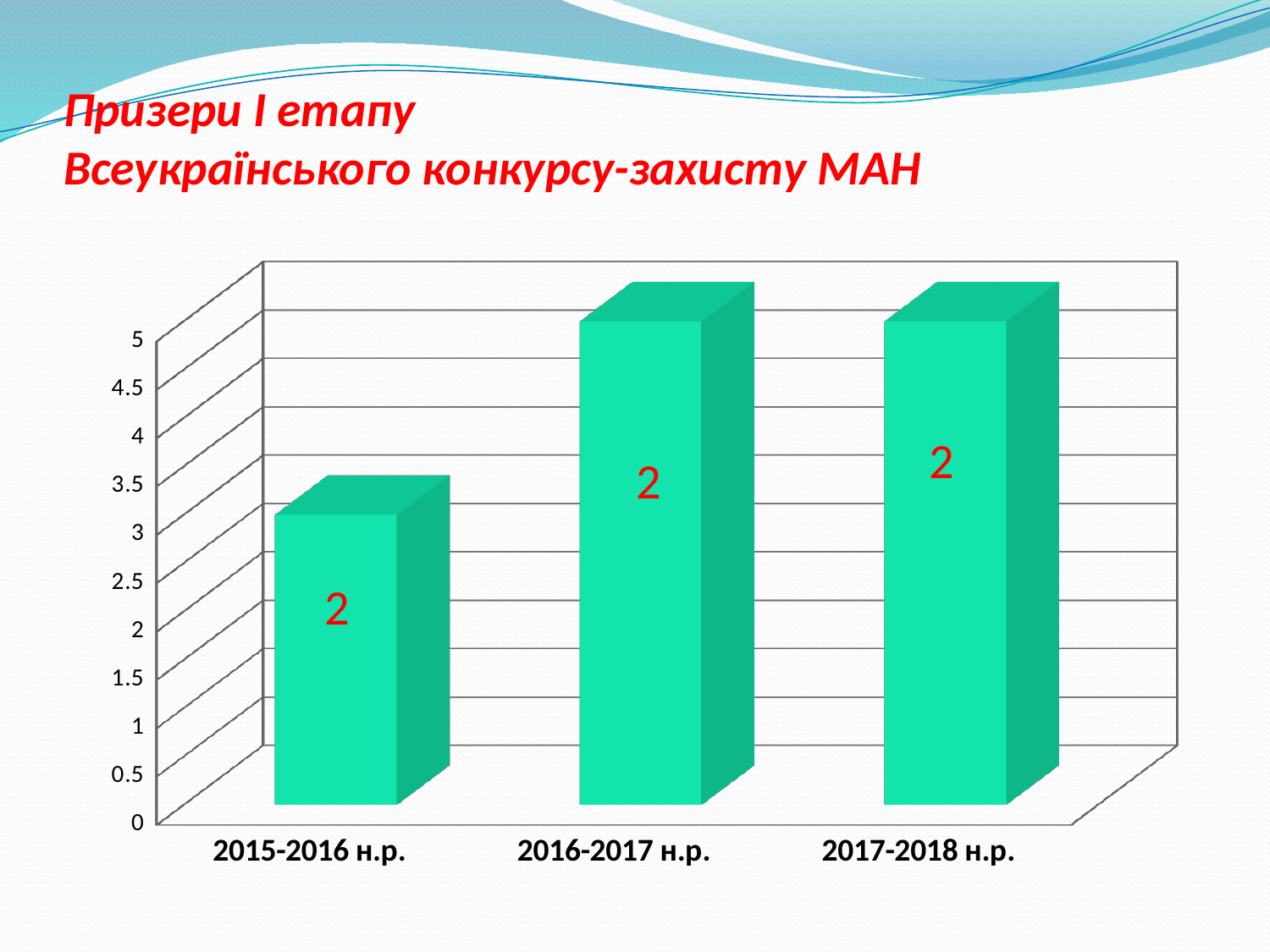
Which category is listed first on the x axis? 2015-2016 н.р. What kind of chart is shown on the slide? bar chart How many categories (academic years) are shown on the x axis? 3 What is the data label shown on the bar for 2017-2018 н.р.? 2 What is the data label shown on the bar for 2016-2017 н.р.? 2 Is the value for 2015-2016 н.р. greater or less than 1? greater What colour are the bars in the chart? green What is the data label shown on the bar for 2015-2016 н.р.? 2 What is the highest value shown on the vertical axis? 5 Is the value for 2015-2016 н.р. greater or less than 4? less